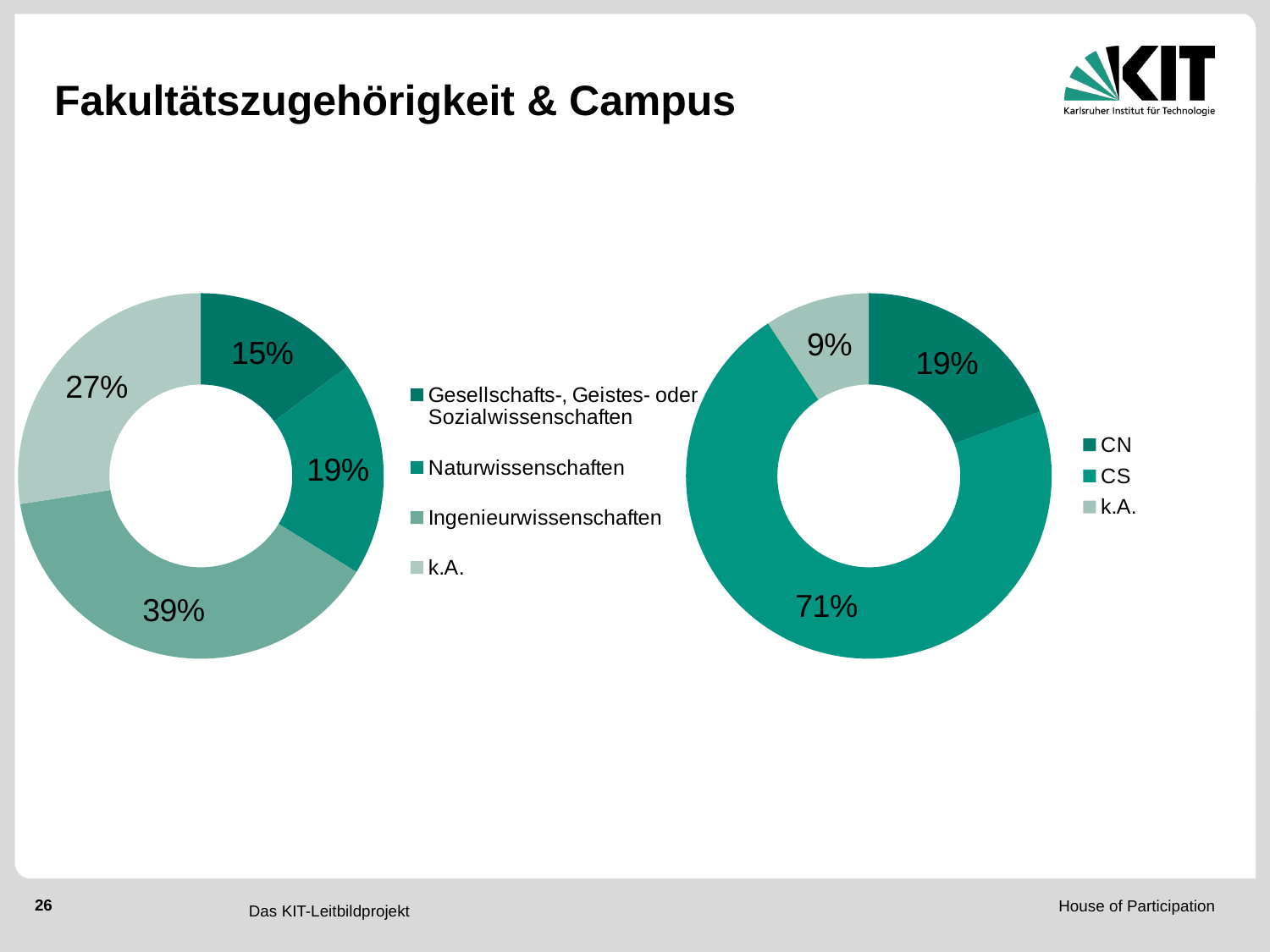
In the left chart, what is the difference in percentage points between Ingenieurwissenschaften and Naturwissenschaften? 20 In the left chart, what percentage is shown for Naturwissenschaften? 19% In the left chart, how many categories does the legend list? 4 In the right chart, what percentage is shown for CN? 19% In the right chart, which category has the smallest share? k.A. In the left chart, what percentage is shown for Ingenieurwissenschaften? 39% In the left chart, what percentage is shown for k.A.? 27% In the left chart, which category has the largest share? Ingenieurwissenschaften In the left chart, which category has the smallest share? Gesellschafts-, Geistes- oder Sozialwissenschaften In the right chart, what percentage is shown for CS? 71% In the right chart, which is larger, CN or k.A.? CN What kind of chart is the right chart? doughnut chart